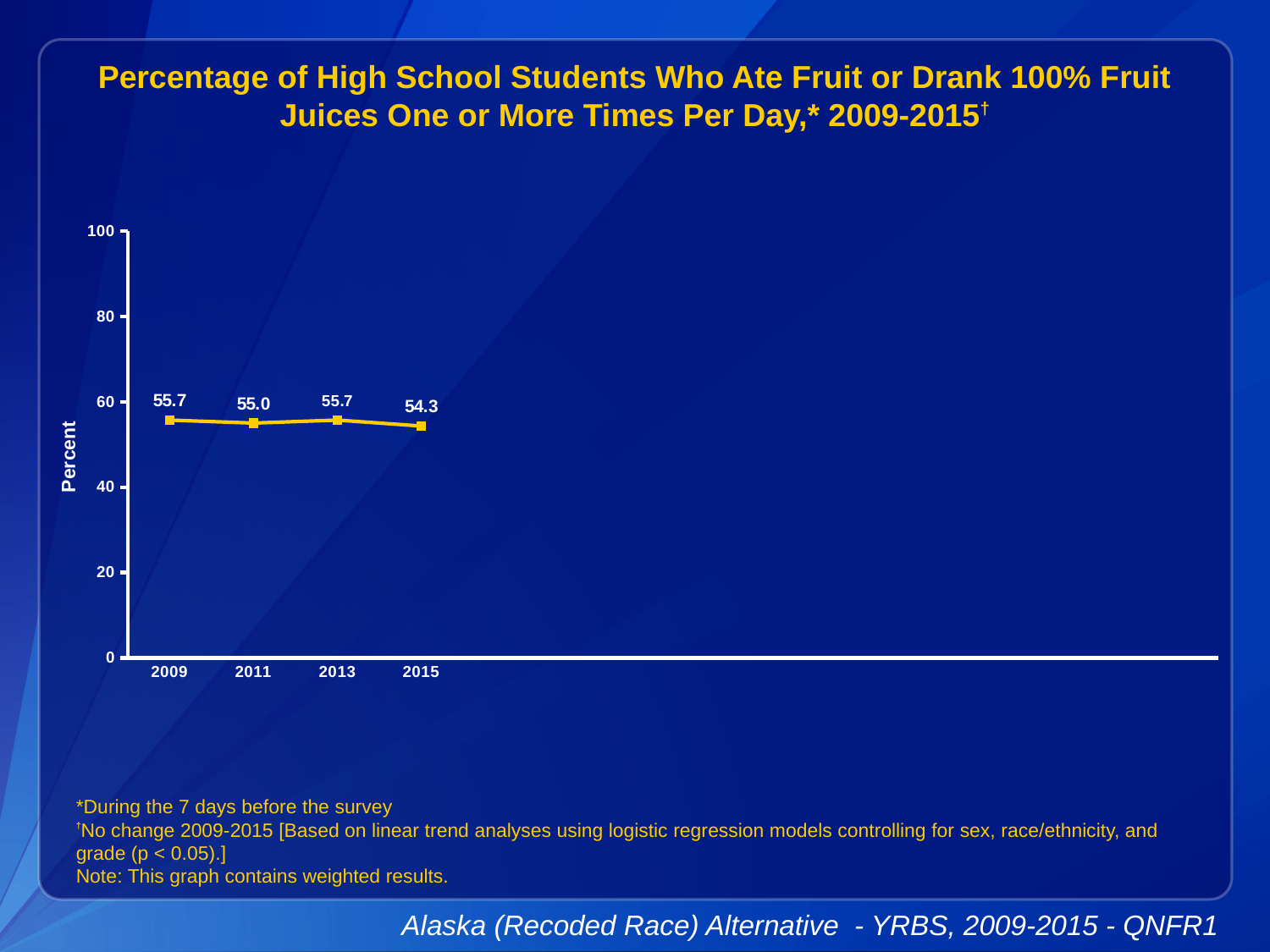
What kind of chart is shown on the slide? line chart What is the difference between the values for 2009 and 2015? 1.4 What is the value for 2015? 54.3 How many years are plotted on the chart? 4 What is the value for 2011? 55.0 What is the label on the vertical axis? Percent Is the value for 2013 greater or less than 60? less What is the value for 2009? 55.7 Which year has the lowest value? 2015 What is the difference between the values for 2011 and 2013? 0.7 Which is larger, the value for 2011 or the value for 2015? 2011 Does the value rise or fall from 2013 to 2015? fall